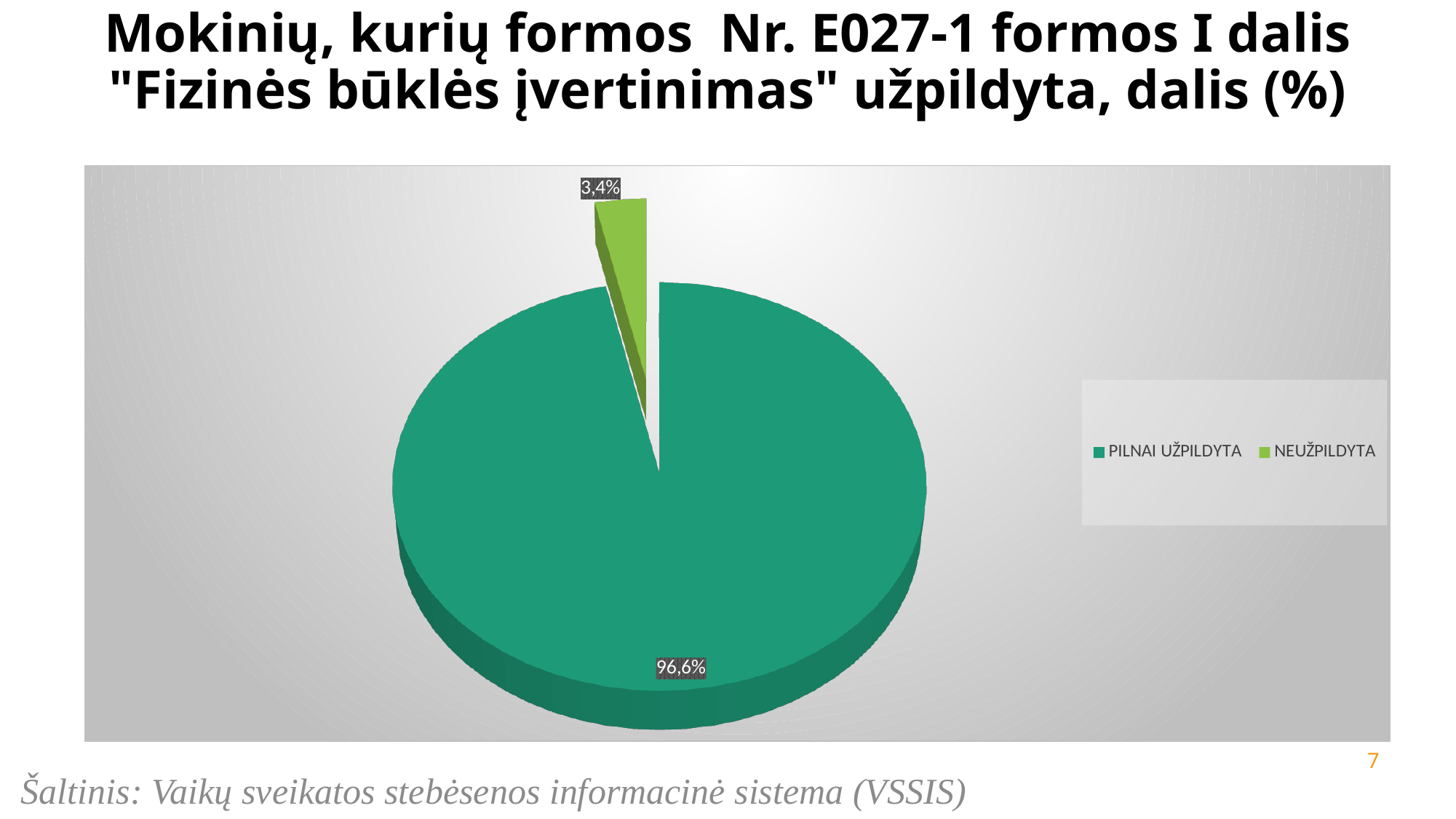
Which category has the smallest slice of the pie? NEUŽPILDYTA What kind of chart is shown on the slide? Pie chart What colour is the NEUŽPILDYTA slice? Green What is the difference in percentage points between PILNAI UŽPILDYTA and NEUŽPILDYTA? 93,2 What share of the pie does PILNAI UŽPILDYTA represent? 96,6% How many entries does the legend list? 2 What share of the pie does NEUŽPILDYTA represent? 3,4% What source is cited below the chart? Vaikų sveikatos stebėsenos informacinė sistema (VSSIS) Which category has the largest slice of the pie? PILNAI UŽPILDYTA How many slices does the pie chart have? 2 Which is larger, the share for PILNAI UŽPILDYTA or for NEUŽPILDYTA? PILNAI UŽPILDYTA